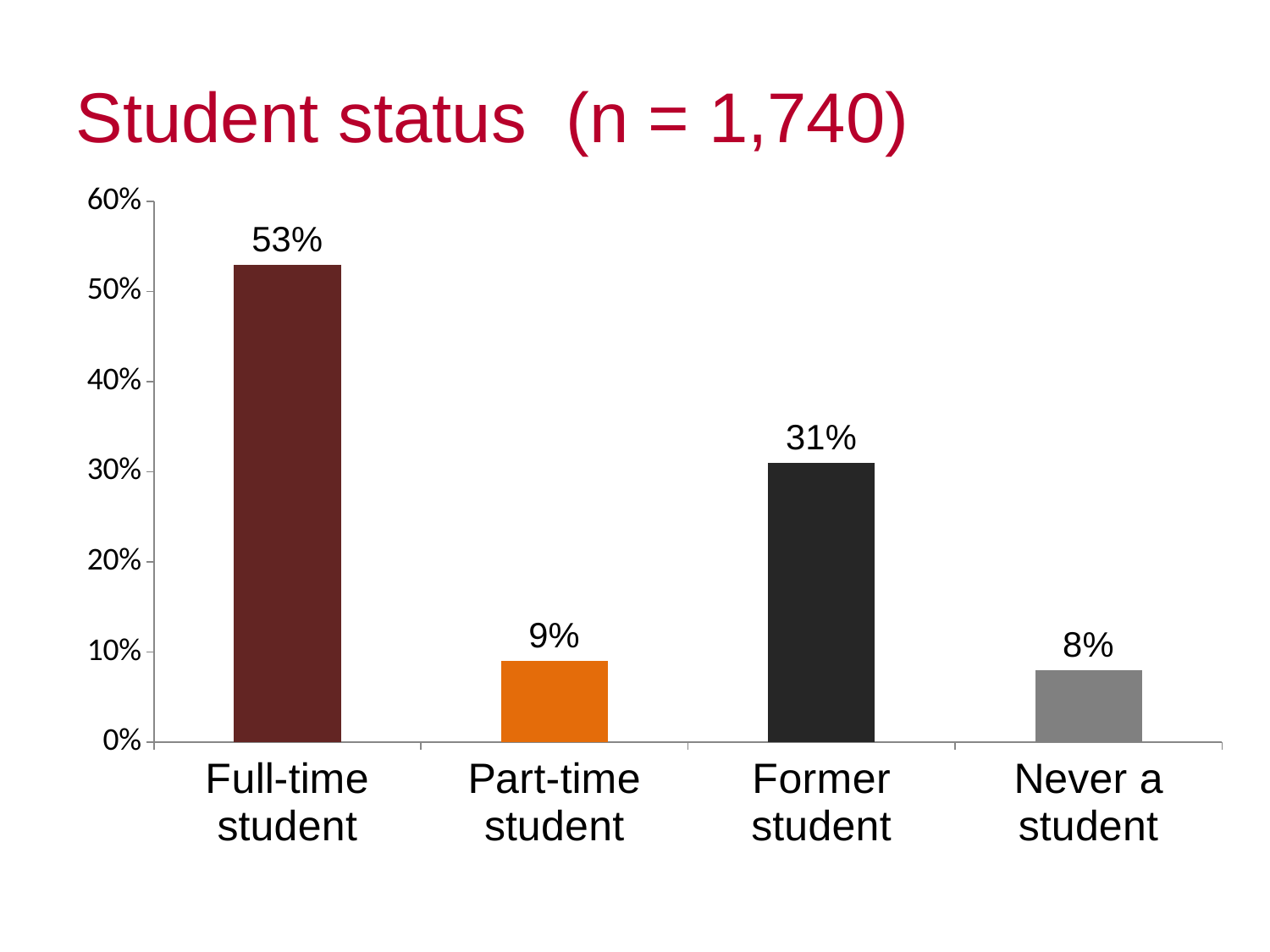
What percentage of respondents are full-time students? 53% What is the sample size (n) given in the chart title? 1,740 Which is larger, the value for Part-time student or the value for Former student? Former student How many student status categories are shown in the chart? 4 What percentage of respondents were never a student? 8% What is the difference between the Part-time student and Never a student values? 1% Which student status category has the highest value? Full-time student Is the value for Former student greater or less than 40%? less What kind of chart is shown on the slide? Bar chart Which student status category has the lowest value? Never a student What is the value shown for Former student? 31% What is the difference between the Full-time student and Former student values? 22%